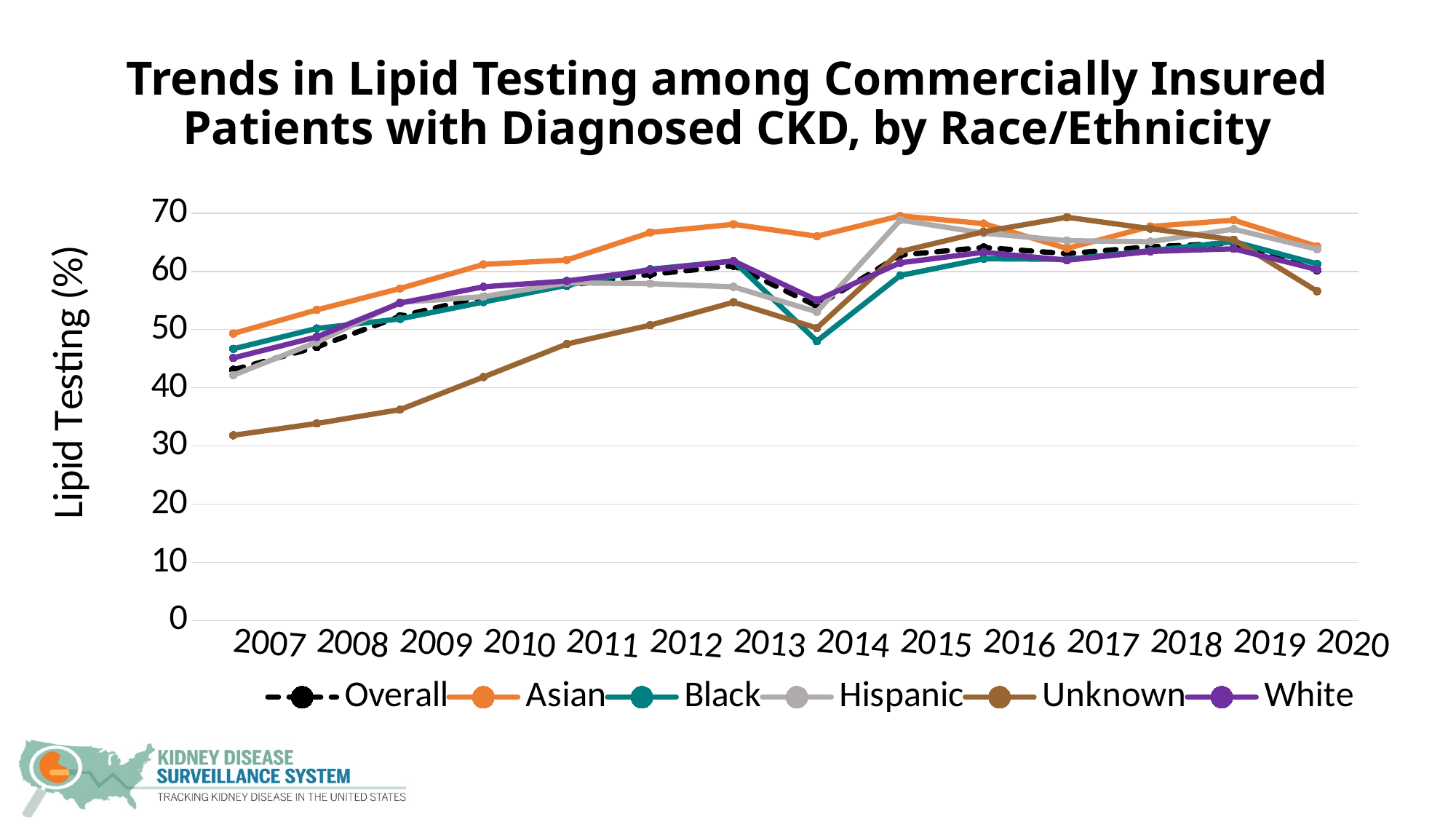
In 2007, which is larger: the value for Asian or the value for Unknown? Asian What kind of chart is shown on the slide? line chart Which race/ethnicity group has the lowest lipid testing value in 2007? Unknown Which series has the lowest value in 2014? Black Is the value for Asian in 2013 greater or less than 60? greater How many series does the legend list? 6 Does the Unknown series rise or fall from 2007 to 2017? rise Which race/ethnicity group has the highest lipid testing value in 2012? Asian Which series has the highest value in 2017? Unknown Is the value for Unknown in 2020 greater or less than 60? less Is the value for Unknown in 2007 greater or less than 40? less How many years are shown along the x axis? 14